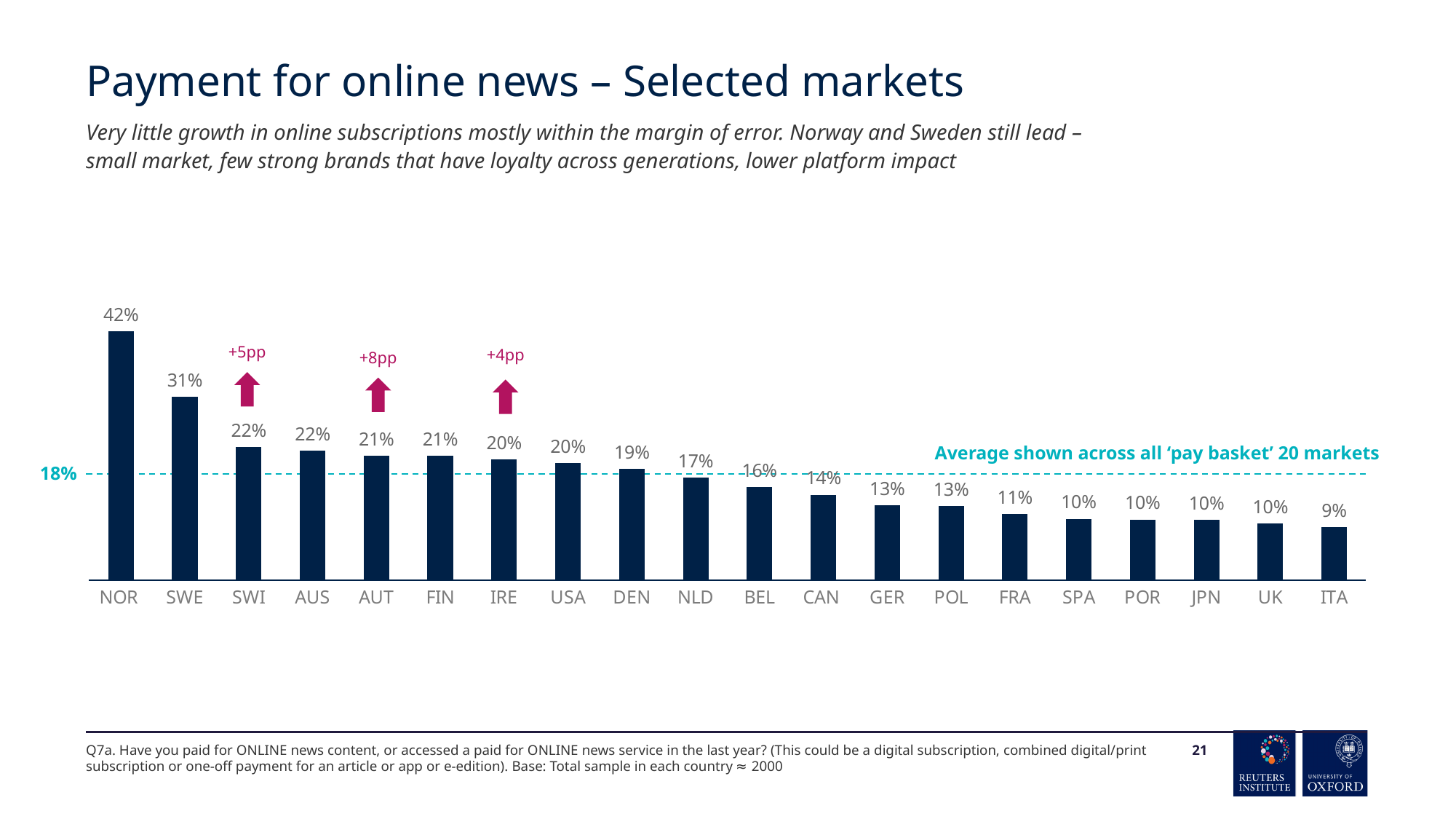
Which country has the lowest value? ITA How many countries are shown on the chart? 20 What is the value for DEN? 19% Do the values rise or fall from left to right along the x axis? Fall What kind of chart is shown on the slide? Bar chart What change is annotated above the AUT bar? +8pp What is the value for NOR? 42% Which country has the highest value? NOR What is the difference between the values for NOR and SWE? 11% What average value is marked by the dashed line? 18% What is the value for FRA? 11% Which has a larger value, USA or CAN? USA